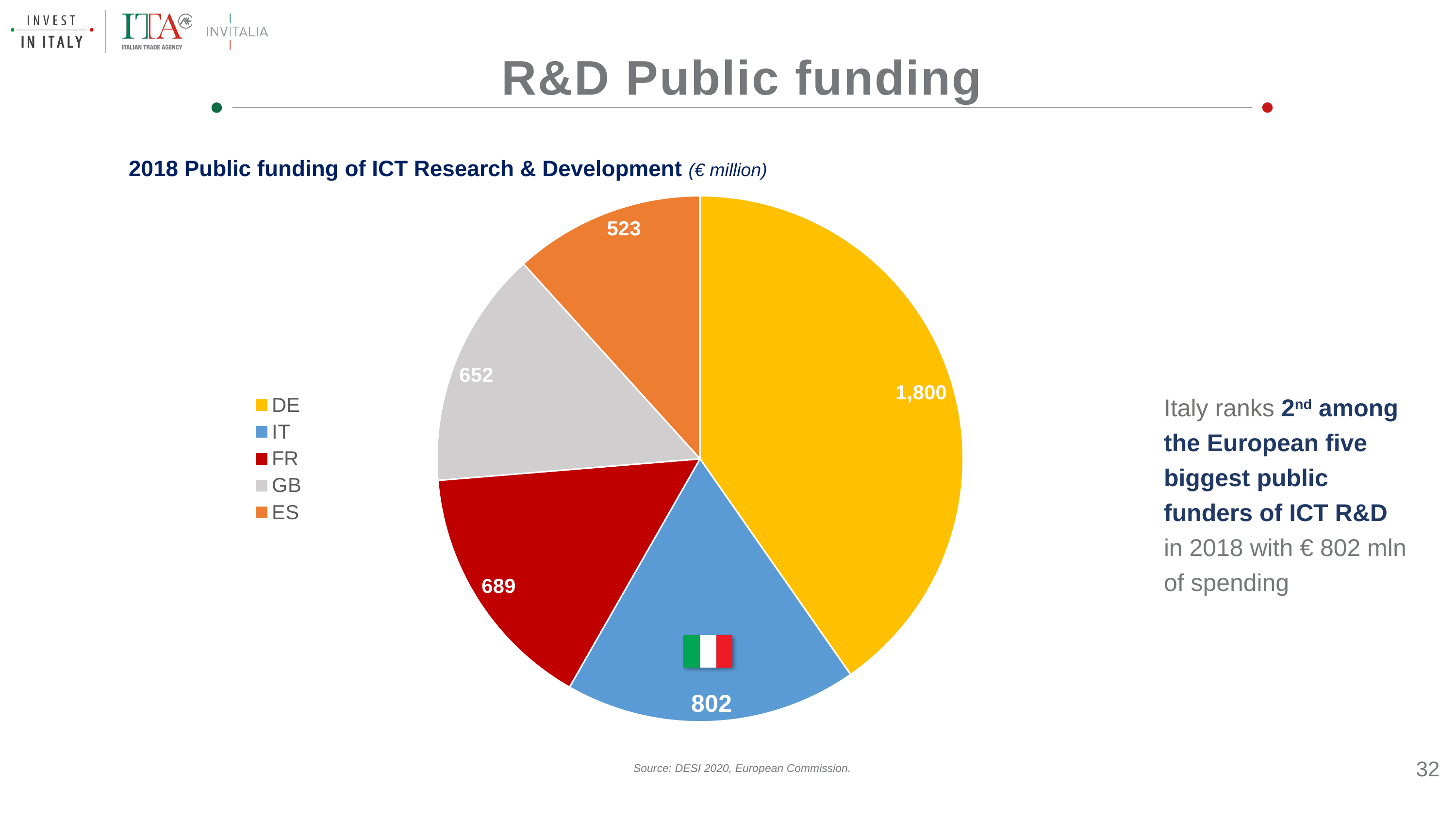
What is the value for DE in the pie chart? 1,800 What is the value for ES in the pie chart? 523 What is the difference between the values for DE and IT? 998 Which country has the smallest slice of the pie chart? ES What is the value for GB in the pie chart? 652 What is the title of the chart? 2018 Public funding of ICT Research & Development (€ million) How many countries are shown in the pie chart? 5 What is the value for FR in the pie chart? 689 What is the value for IT in the pie chart? 802 Which is larger, the value for FR or the value for GB? FR What type of chart is shown on the slide? pie chart Which country has the largest slice of the pie chart? DE